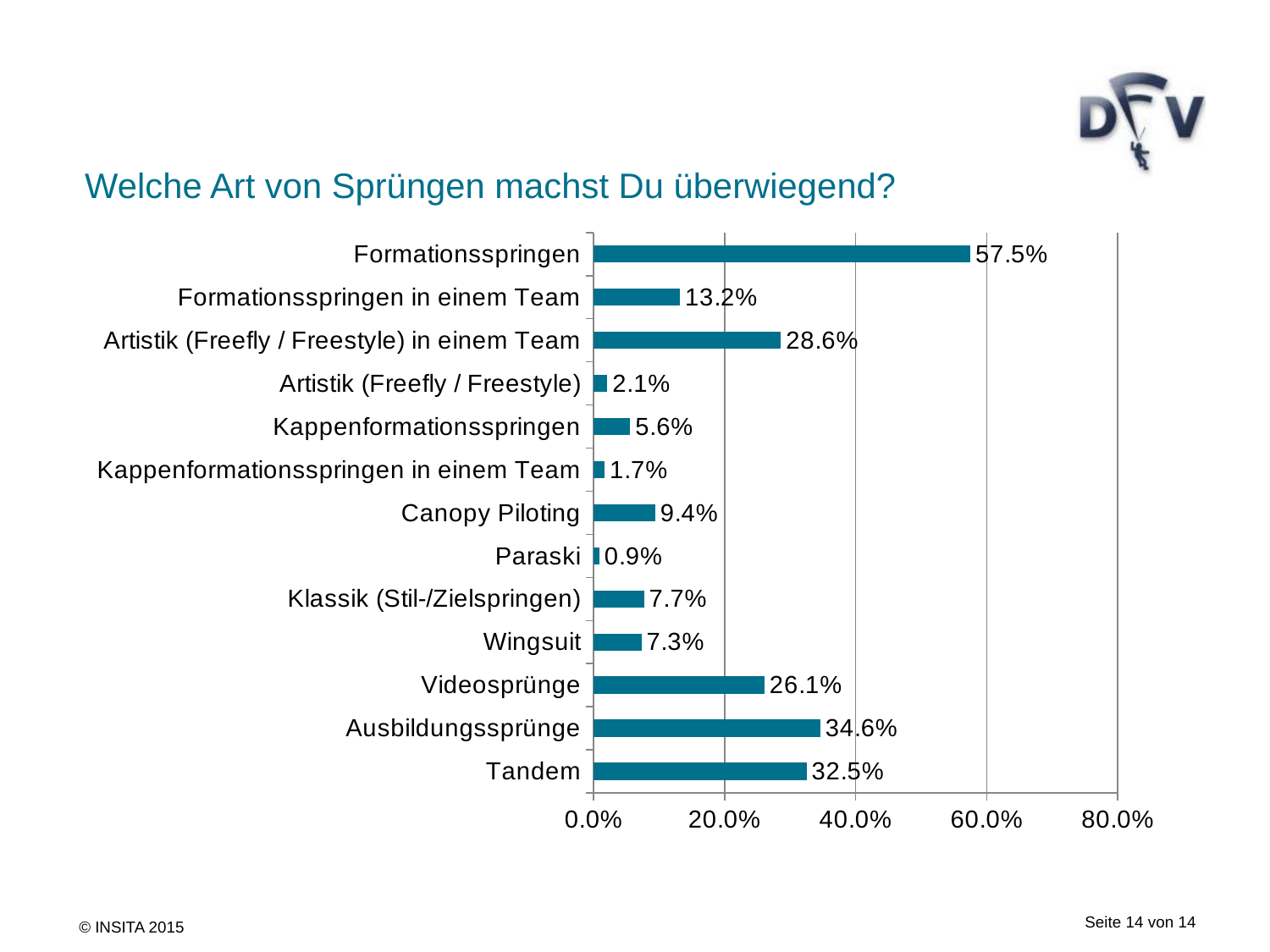
Which category has the lowest value? Paraski What is the title of the chart? Welche Art von Sprüngen machst Du überwiegend? How many categories are shown in the chart? 13 What is the difference between Ausbildungssprünge and Tandem? 2.1% What is the difference between Formationsspringen and Formationsspringen in einem Team? 44.3% What is the value for Ausbildungssprünge? 34.6% What is the value for Formationsspringen? 57.5% Is the value for Formationsspringen greater or less than 40.0%? greater What kind of chart is shown on the slide? bar chart Which category has the highest value? Formationsspringen Which is larger, Artistik (Freefly / Freestyle) in einem Team or Videosprünge? Artistik (Freefly / Freestyle) in einem Team What is the value for Canopy Piloting? 9.4%